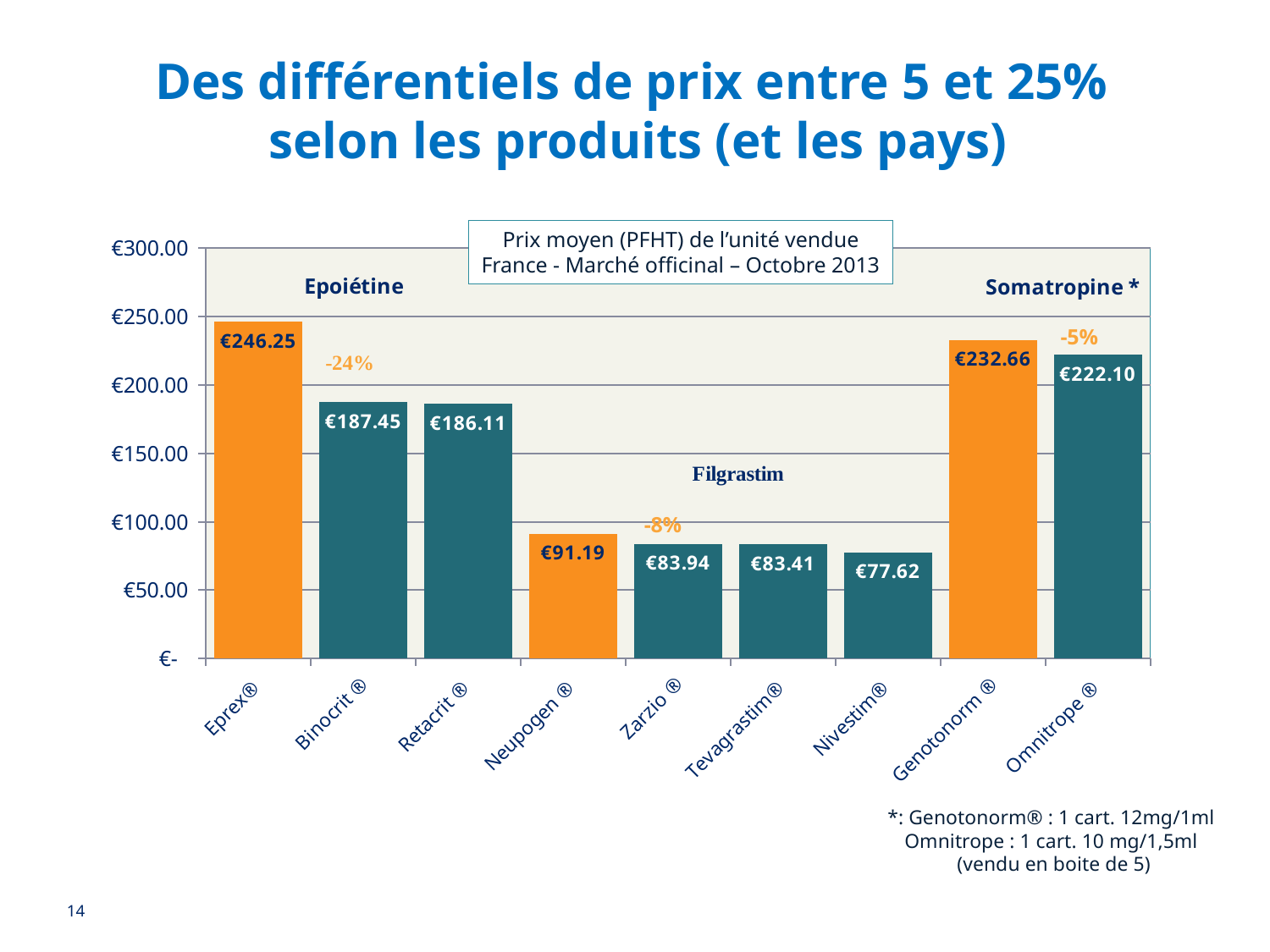
Which product has the highest average price? Eprex® What is the value for Genotonorm ®? €232.66 What is the difference between the values for Genotonorm ® and Omnitrope ®? €10.56 What is the difference between the values for Eprex® and Binocrit ®? €58.80 What percentage difference is annotated between Eprex® and Binocrit ®? -24% Which product has the lowest average price? Nivestim® What is the value for Nivestim®? €77.62 Is the value for Neupogen ® greater or less than €100.00? less How many products are shown on the x axis? 9 What kind of chart is shown on the slide? bar chart What is the value for Eprex®? €246.25 Which is larger, the value for Neupogen ® or the value for Zarzio ®? Neupogen ®